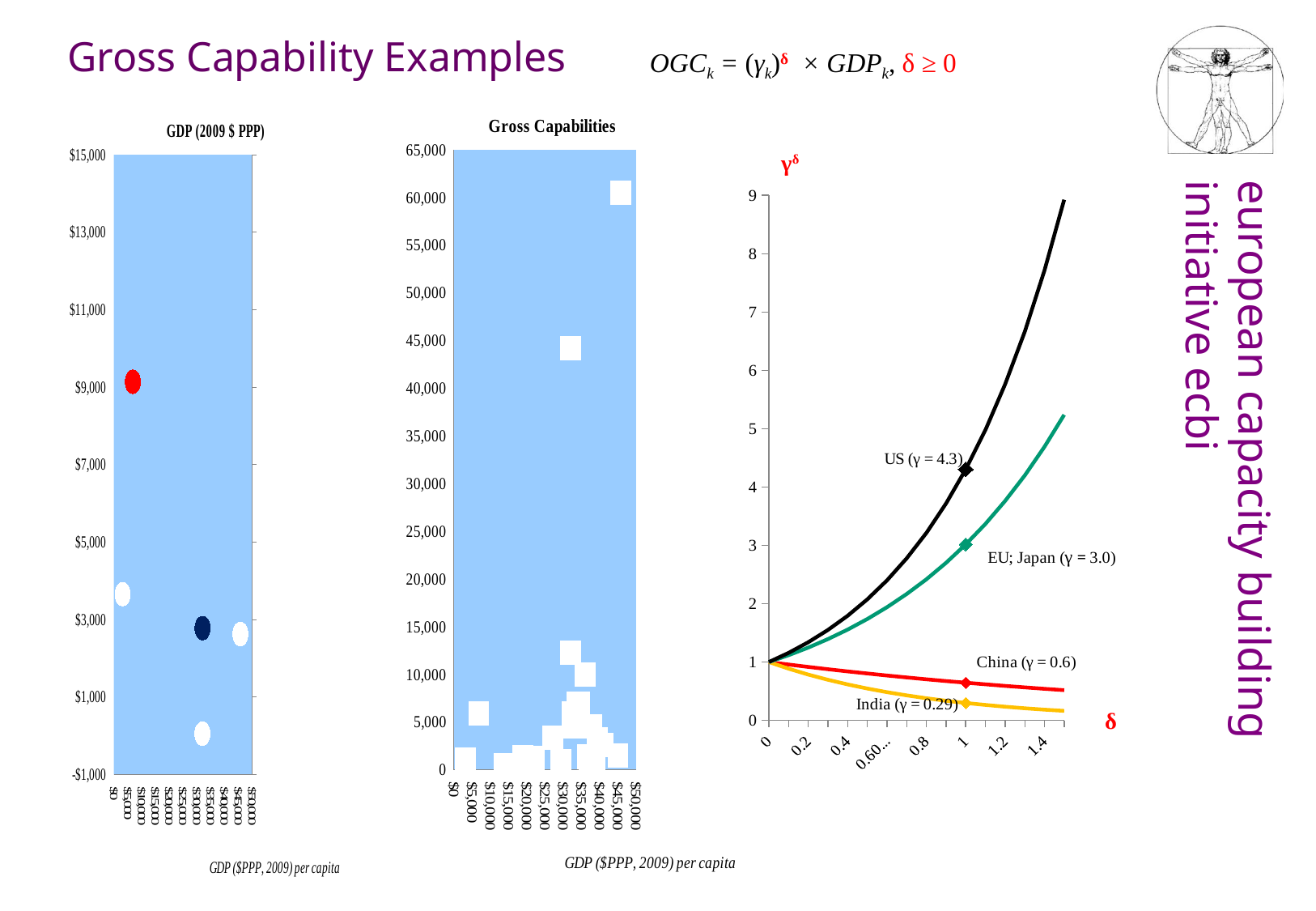
In the chart on the right (γ^δ vs δ), what is the difference between the γ values of the US and EU; Japan? 1.3 In the chart on the right (γ^δ vs δ), does the India curve rise or fall as δ increases? falls In the chart on the right (γ^δ vs δ), does the US curve rise or fall as δ increases? rises In the chart on the right (γ^δ vs δ), what kind of chart is it? line chart In the chart on the right (γ^δ vs δ), which curve has the lowest value at δ = 1? India (γ = 0.29) In the chart on the right (γ^δ vs δ), what is the γ value given for China? 0.6 In the chart on the right (γ^δ vs δ), which curve has the highest value at δ = 1? US (γ = 4.3) In the chart on the right (γ^δ vs δ), is the US curve at δ = 1.2 greater or less than 5? greater In the chart on the right (γ^δ vs δ), how many curves are plotted? 4 In the chart titled 'GDP (2009 $ PPP)', is the red point's value greater or less than $7,000? greater In the chart on the right (γ^δ vs δ), what is the γ value given for EU; Japan? 3.0 What is the title of the middle chart? Gross Capabilities